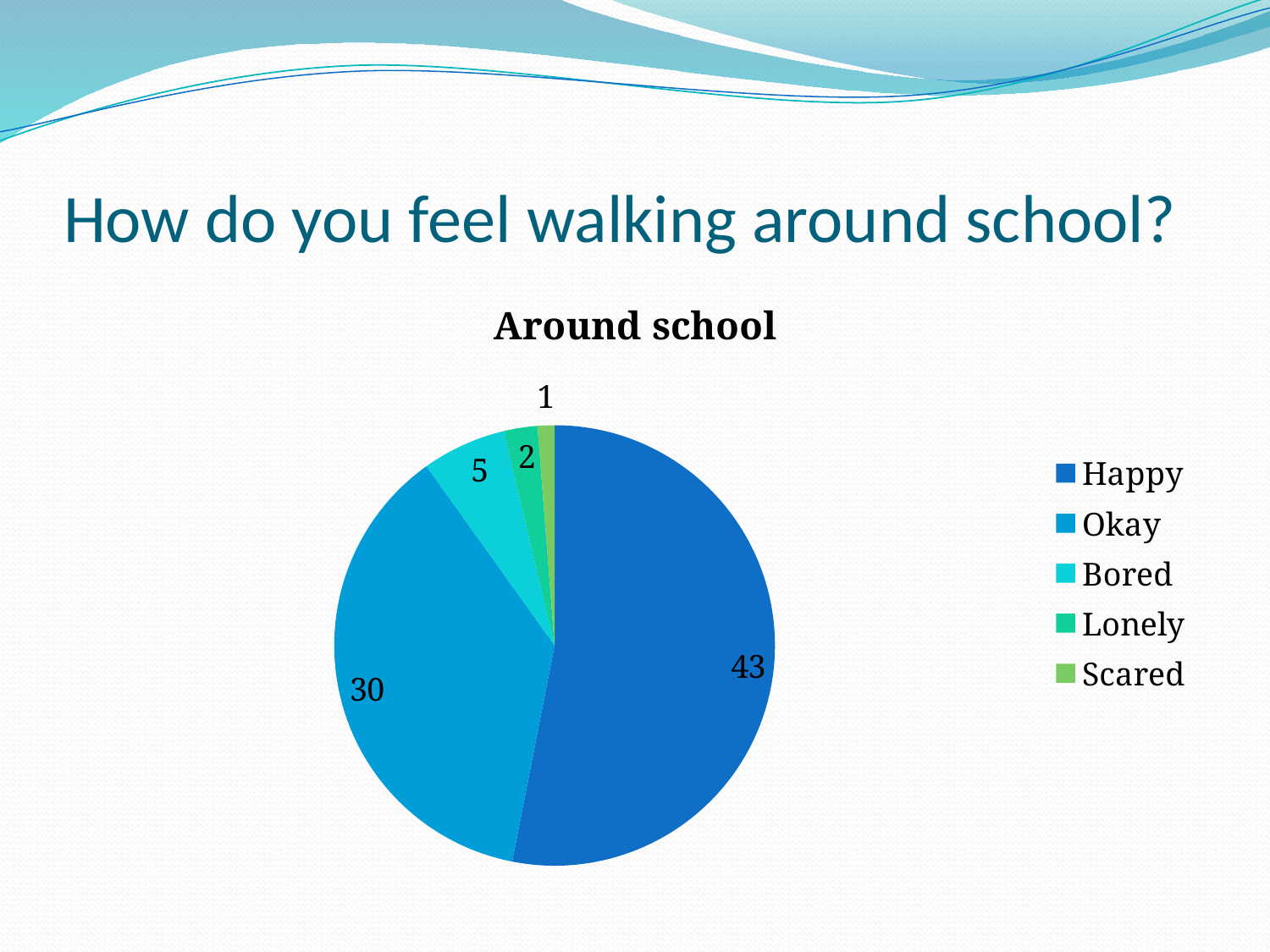
What is the value for Lonely? 2 What is the value for Scared? 1 What is the difference between the values for Happy and Okay? 13 Which category has the smallest slice? Scared What is the value for Bored? 5 What is the title of the chart? Around school What is the value for Okay? 30 What is the value for Happy? 43 Which category has the largest slice? Happy What type of chart is shown on the slide? pie chart Which is larger, the value for Bored or the value for Lonely? Bored How many categories does the legend list? 5